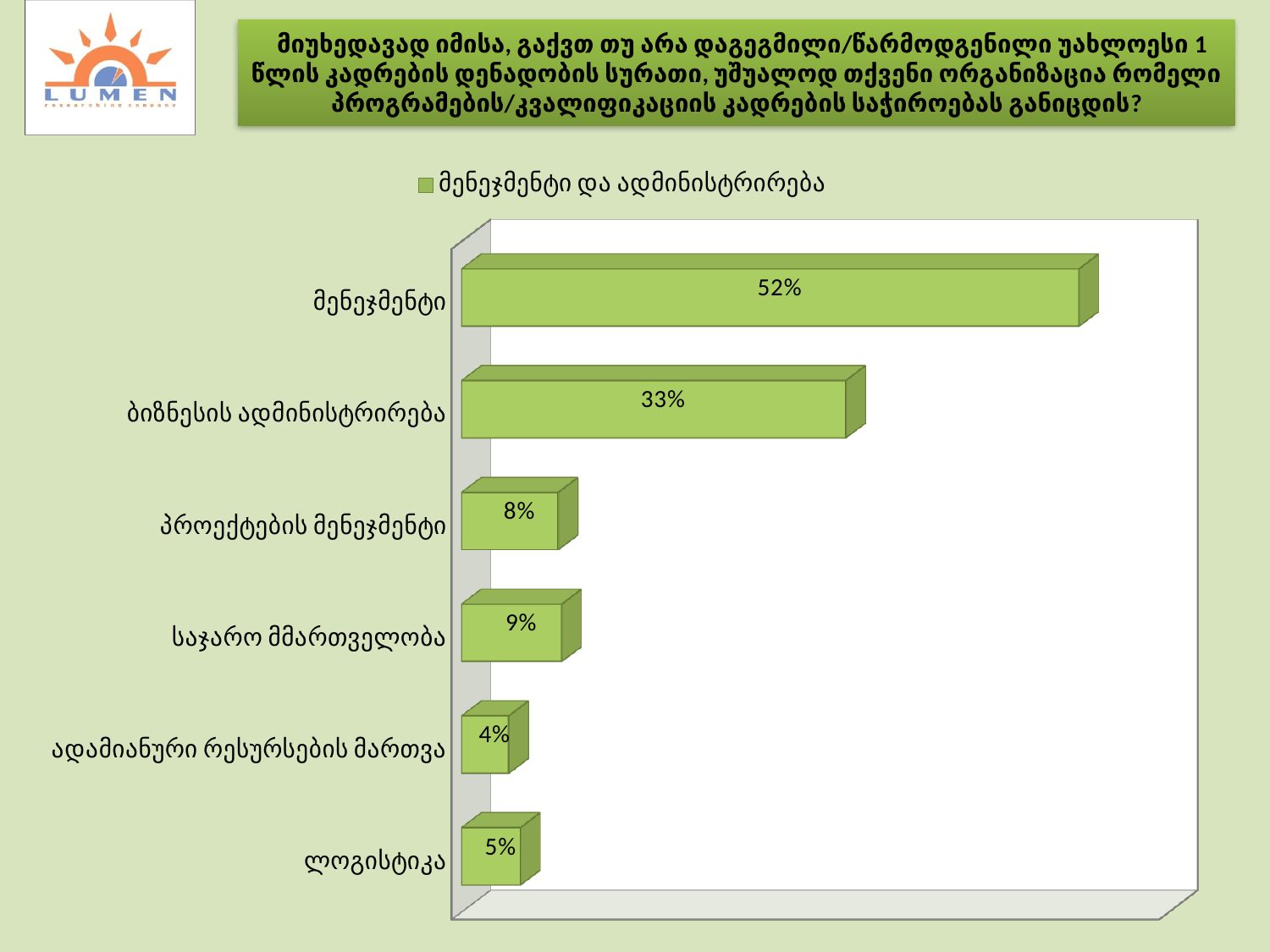
Which category has the highest value? მენეჯმენტი What value is shown for ადამიანური რესურსების მართვა? 4% What value is shown for ბიზნესის ადმინისტრირება? 33% How many series does the legend list? 1 What is the legend entry shown above the chart? მენეჯმენტი და ადმინისტრირება Which is larger, the value for საჯარო მმართველობა or the value for პროექტების მენეჯმენტი? საჯარო მმართველობა What is the difference between the values for მენეჯმენტი and ბიზნესის ადმინისტრირება? 19% Which category has the lowest value? ადამიანური რესურსების მართვა What value is shown for მენეჯმენტი? 52% What kind of chart is shown on the slide? Bar chart How many categories are shown in the chart? 6 What value is shown for ლოგისტიკა? 5%